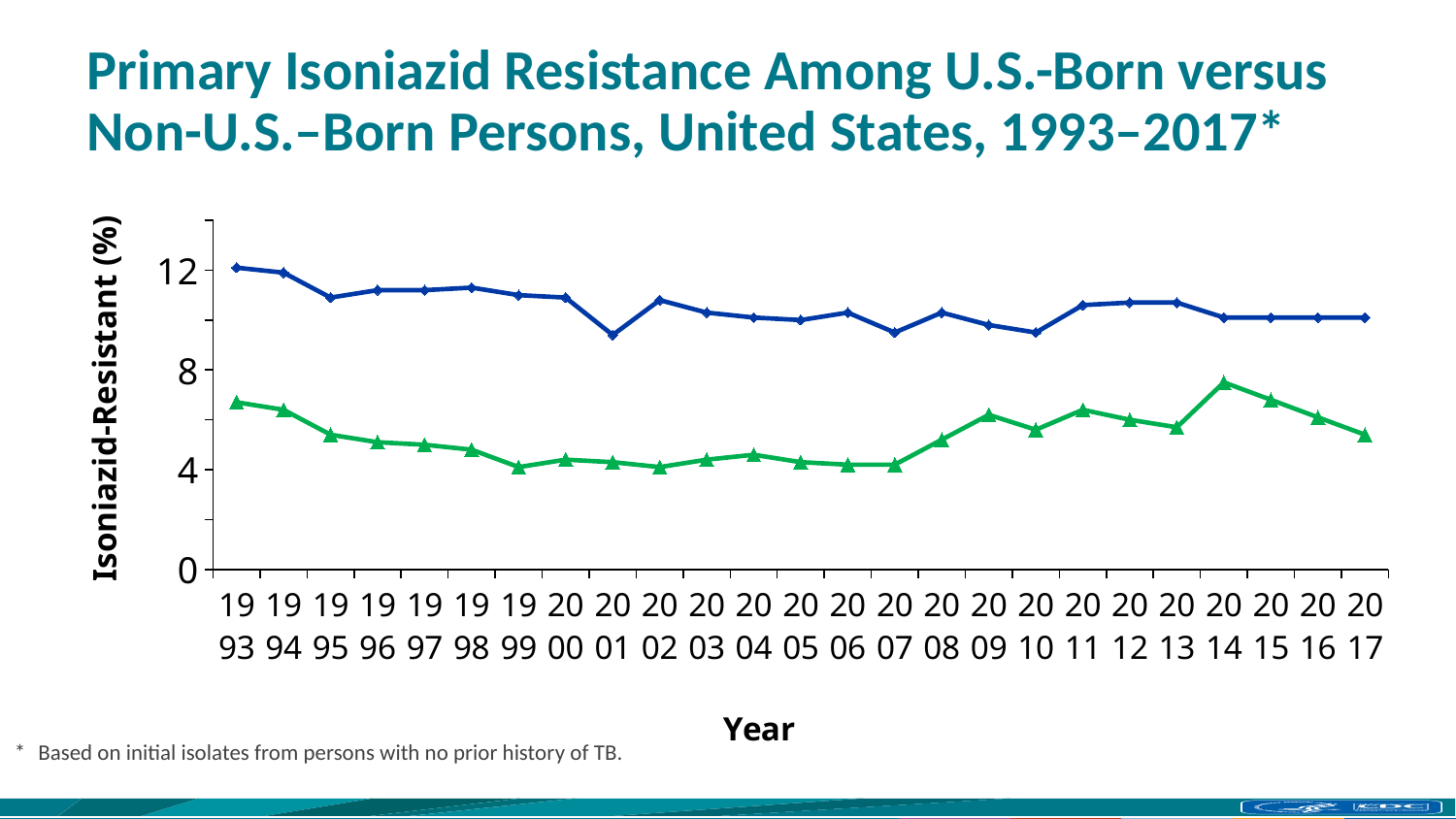
What is the first year shown on the x axis? 1993 What is the last year shown on the x axis? 2017 Is the value of the green line in 1993 greater or less than 8? less What kind of chart is shown on the slide? line chart Does the green line rise or fall between 2007 and 2009? rise In 2017, which line has the higher value, the blue line or the green line? the blue line How many years are plotted along the x axis? 25 Is the value of the green line in 2014 greater or less than 4? greater What is the label of the y axis? Isoniazid-Resistant (%) Is the value of the blue line in 2001 greater or less than 8? greater What is the label of the x axis? Year In which year does the green line with triangle markers reach its highest value? 2014